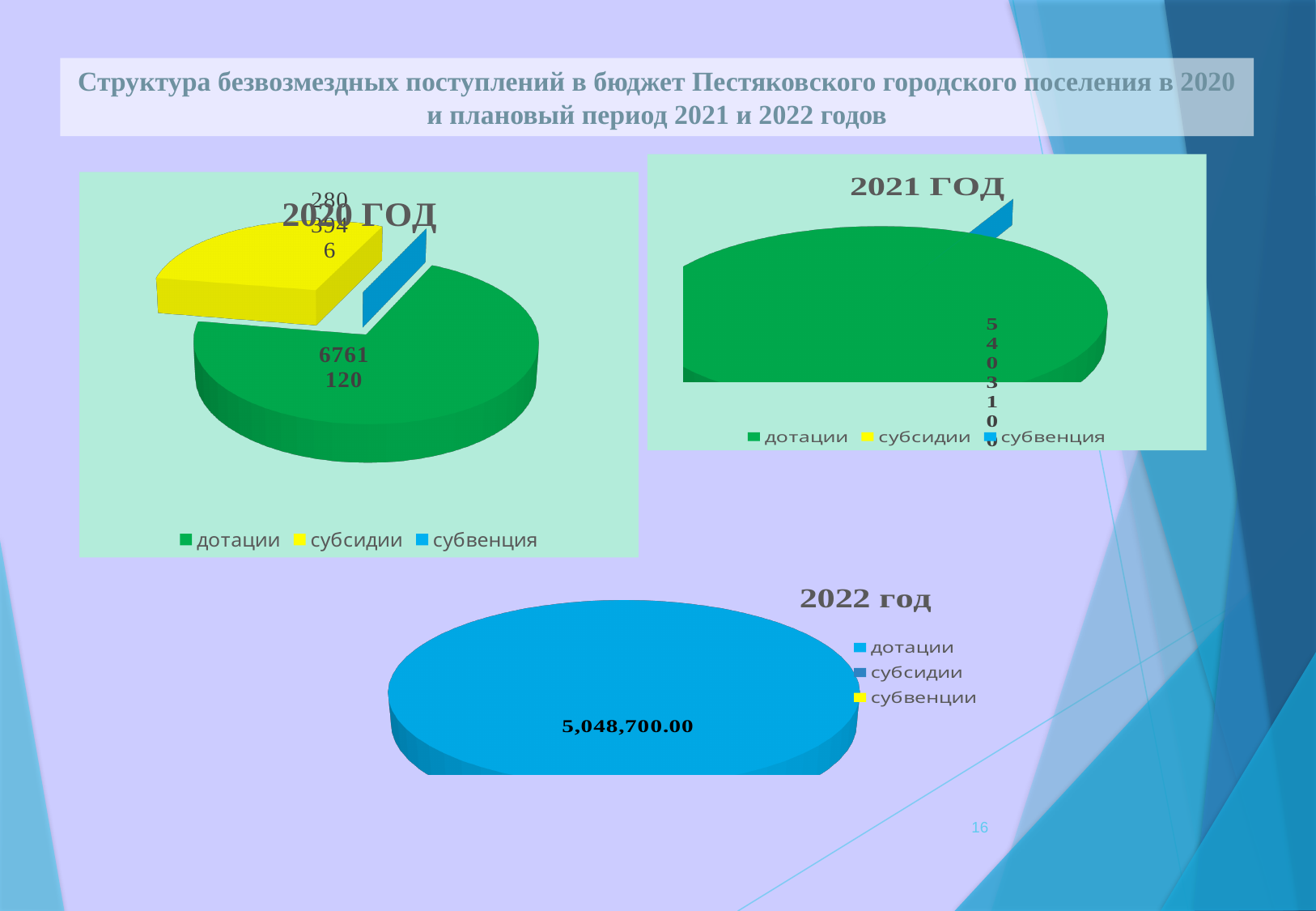
In the 2021 ГОД chart, which category has the largest slice? дотации How many pie charts are shown on the slide? 3 In the 2021 ГОД chart, what value is printed on the green slice? 5403100 How many entries does the legend of the 2022 год chart list? 3 How many entries does the legend of the 2020 ГОД chart list? 3 In the 2020 ГОД chart, which category has the largest slice? дотации In the 2022 год chart, what value is printed on the pie? 5,048,700.00 In the 2020 ГОД chart, which slice is larger, дотации or субсидии? дотации In the 2020 ГОД chart, which category has the smallest slice? субвенция In the 2021 ГОД chart, which slice is larger, дотации or субвенция? дотации What kind of chart is the 2020 ГОД chart? pie chart In the 2020 ГОД chart, what colour represents субсидии? yellow